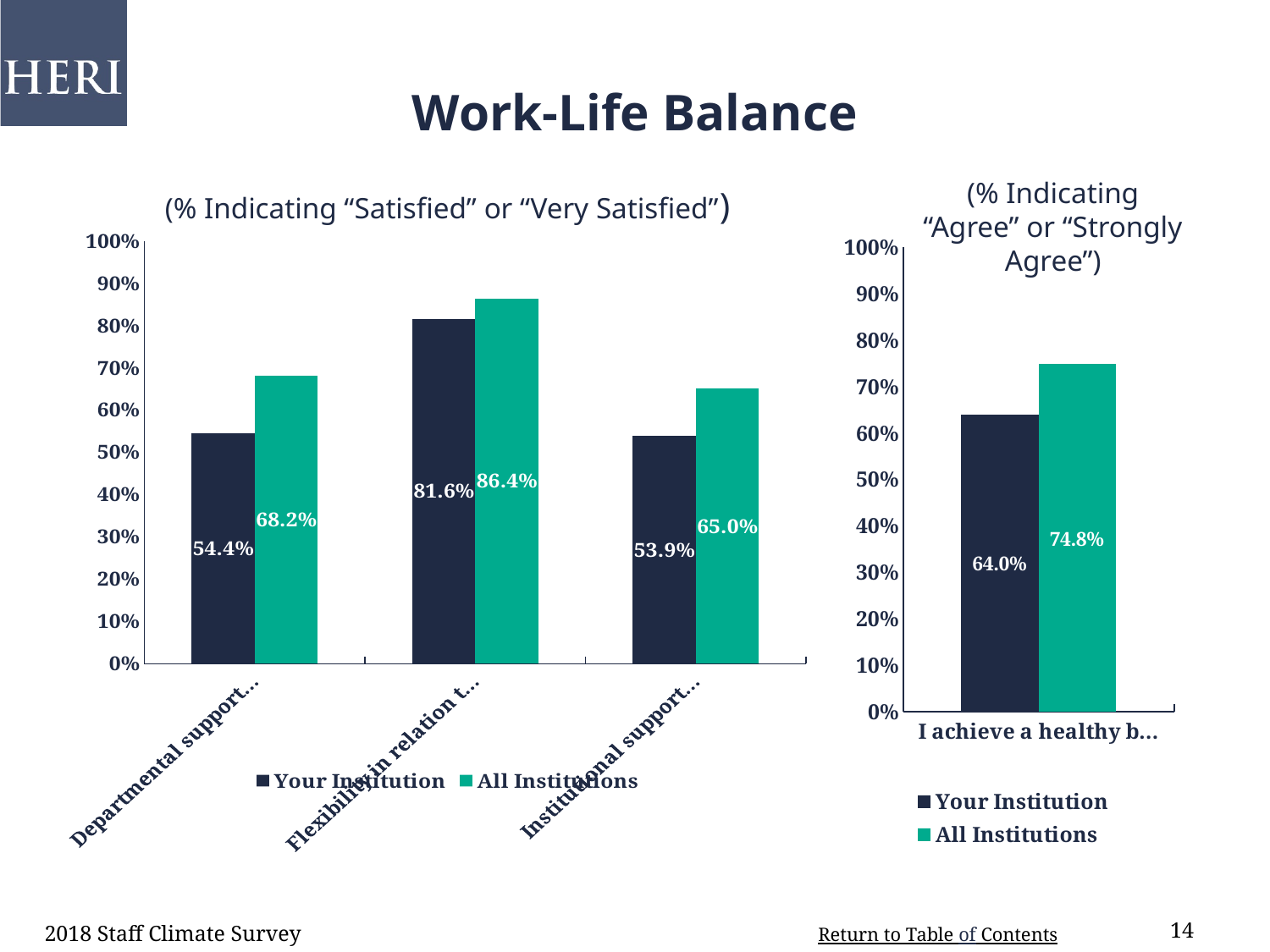
In the left chart (% Indicating "Satisfied" or "Very Satisfied"), what is the value for Your Institution for the Institutional support category? 53.9% In the left chart (% Indicating "Satisfied" or "Very Satisfied"), which category has the highest value for All Institutions? Flexibility in relation t... In the right chart (% Indicating "Agree" or "Strongly Agree"), what is the value for All Institutions? 74.8% In the left chart (% Indicating "Satisfied" or "Very Satisfied"), what is the difference between All Institutions and Your Institution for the Departmental support category? 13.8% What kind of chart is the right chart (% Indicating "Agree" or "Strongly Agree")? Bar chart In the right chart (% Indicating "Agree" or "Strongly Agree"), what is the difference between All Institutions and Your Institution? 10.8% In the left chart (% Indicating "Satisfied" or "Very Satisfied"), what is the value for All Institutions for the Departmental support category? 68.2% In the left chart (% Indicating "Satisfied" or "Very Satisfied"), what is the value for Your Institution for the Flexibility category? 81.6% In the right chart (% Indicating "Agree" or "Strongly Agree"), how many series does the legend list? 2 In the left chart (% Indicating "Satisfied" or "Very Satisfied"), which is larger for the Flexibility category: Your Institution or All Institutions? All Institutions In the left chart (% Indicating "Satisfied" or "Very Satisfied"), how many categories are shown on the x axis? 3 In the left chart (% Indicating "Satisfied" or "Very Satisfied"), which category has the lowest value for Your Institution? Institutional support...